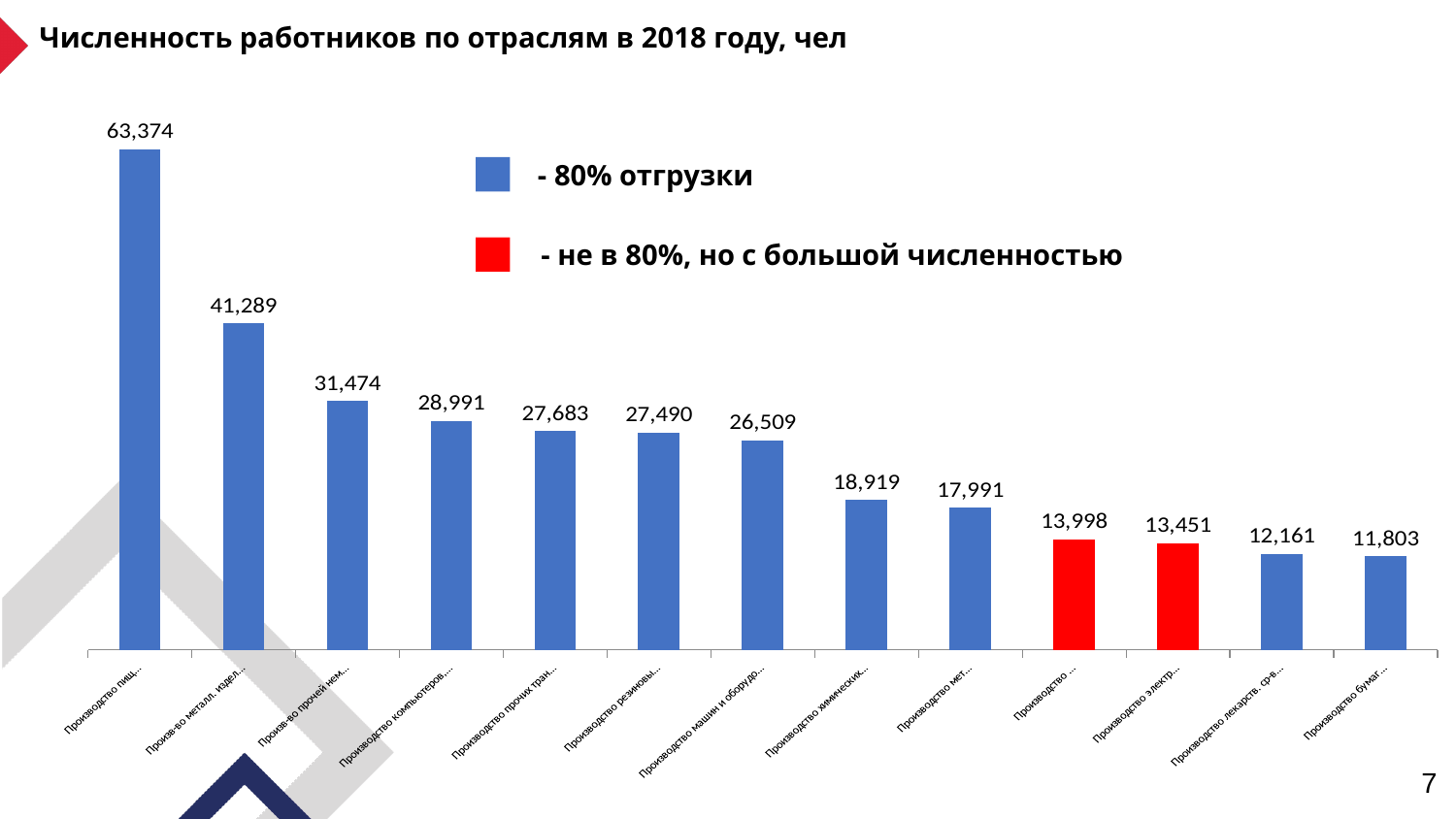
How many bars does the chart contain? 13 What is the difference between the two red bars (13,998 and 13,451)? 547 What is the value of the second bar from the left (Произв-во металл. издел...)? 41,289 How many bars in the chart are coloured red? 2 What is the value of the third bar from the left (Произв-во прочей нем...)? 31,474 Do the bar values rise or fall from left to right across the chart? fall What is the highest value shown in the chart? 63,374 What kind of chart is shown on the slide? bar chart What is the difference between the first bar (63,374) and the second bar (41,289)? 22,085 Which is larger: the fifth bar from the left (27,683) or the sixth bar (27,490)? the fifth bar, 27,683 What are the values of the two red bars? 13,998 and 13,451 What is the lowest value shown in the chart? 11,803